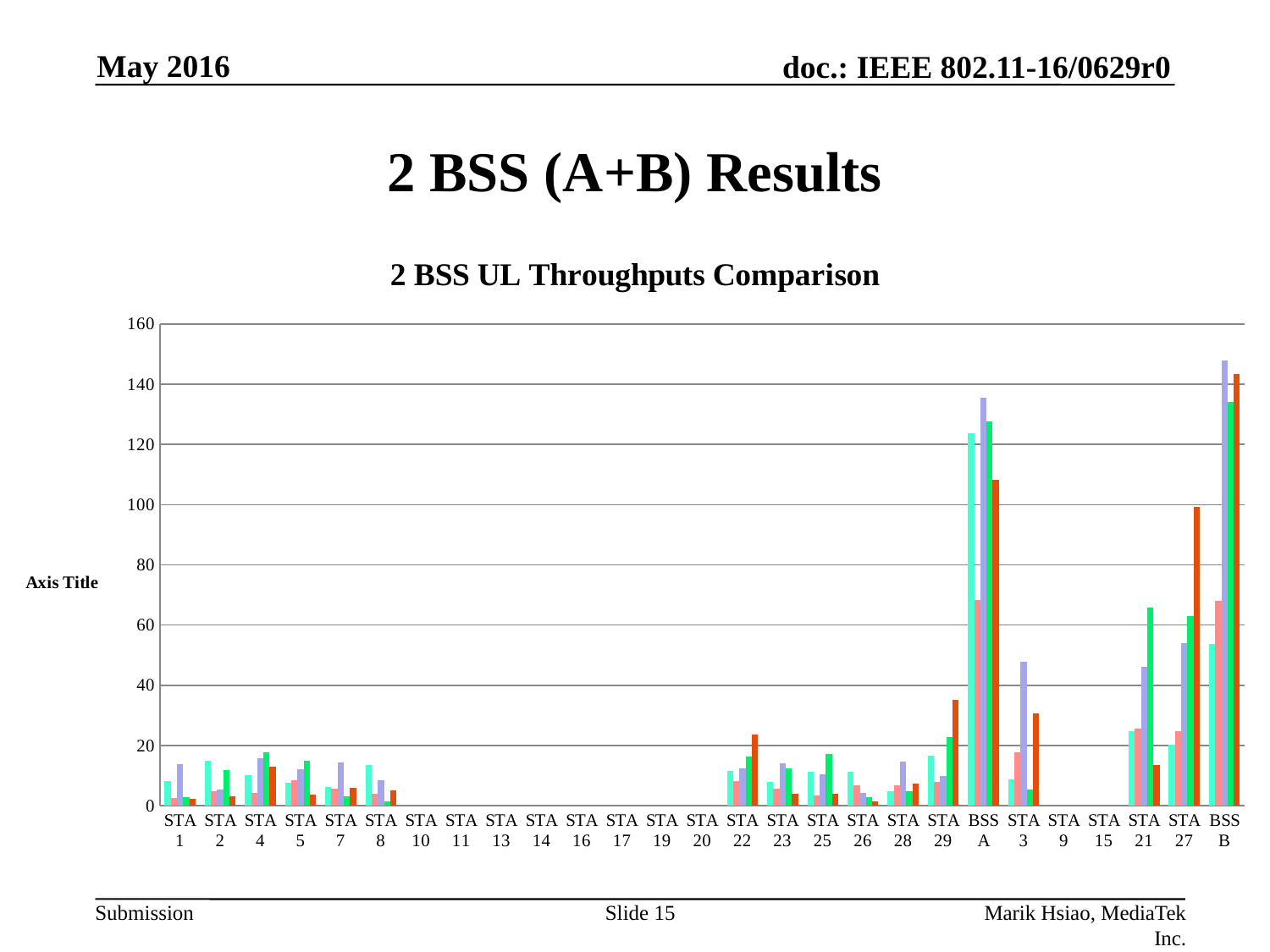
What kind of chart is shown on the slide? bar chart Is the tallest bar for STA 21 greater or less than 60? greater Which category has the tallest bar in the chart? BSS B How many categories are shown along the x axis of the chart? 27 What is the title of the chart? 2 BSS UL Throughputs Comparison Is the tallest bar for BSS A greater or less than 100? greater Is the tallest bar for STA 3 greater or less than 40? greater Which has the taller bars, BSS A or BSS B? BSS B Which has the taller bars, STA 3 or STA 1? STA 3